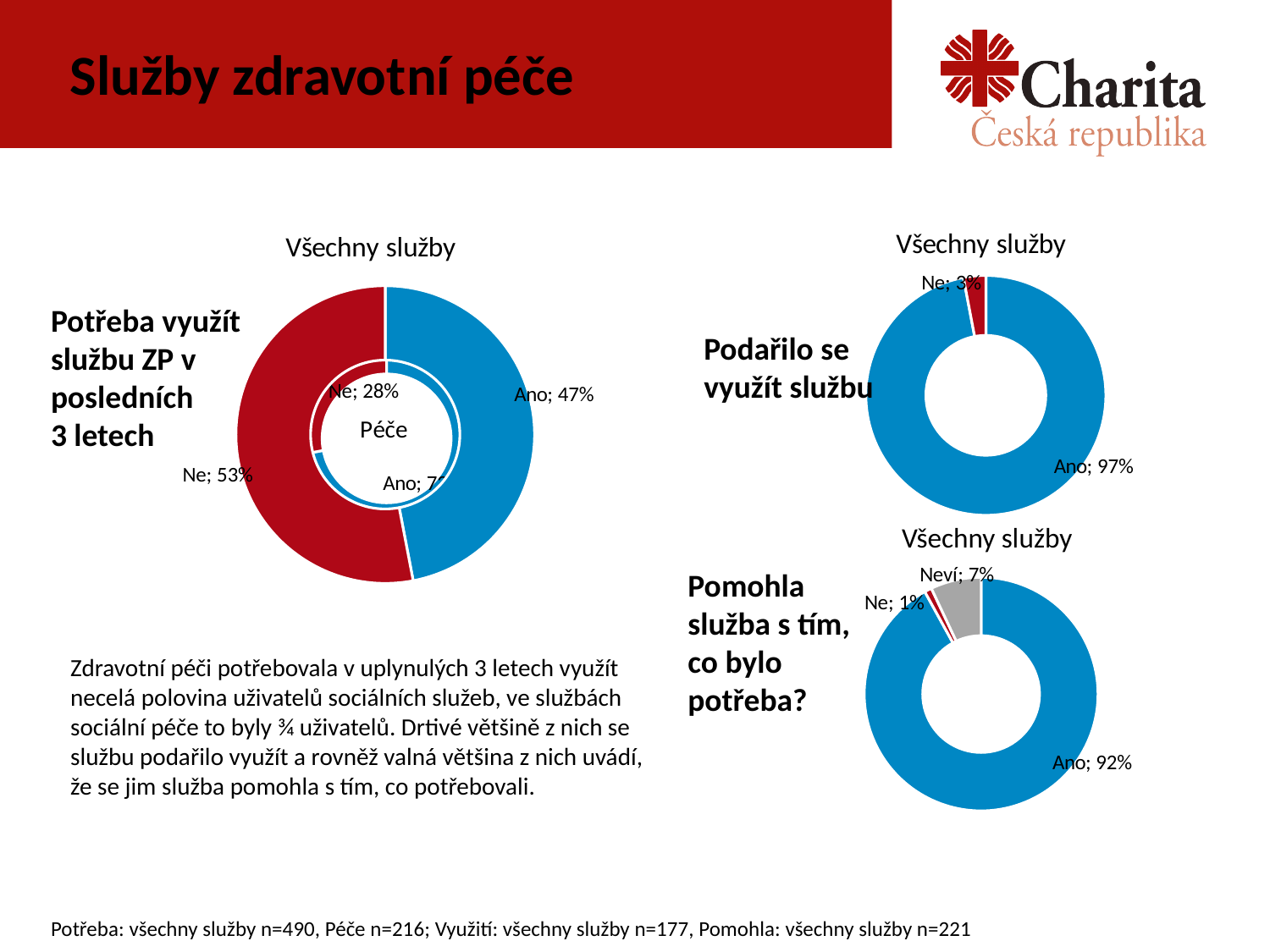
In the chart 'Potřeba využít službu ZP v posledních 3 letech', what is the value for 'Ne' in the outer ring (Všechny služby)? 53% In the chart 'Potřeba využít službu ZP v posledních 3 letech', what is the value for 'Ne' in the inner ring (Péče)? 28% In the chart 'Potřeba využít službu ZP v posledních 3 letech', what is the difference between 'Ne' and 'Ano' in the outer ring? 6% In the chart 'Potřeba využít službu ZP v posledních 3 letech', what is the value for 'Ano' in the outer ring (Všechny služby)? 47% In the chart 'Podařilo se využít službu', what is the value for 'Ne'? 3% In the chart 'Pomohla služba s tím, co bylo potřeba?', what is the value for 'Neví'? 7% What type of chart is used for 'Podařilo se využít službu'? Doughnut chart In the chart 'Potřeba využít službu ZP v posledních 3 letech', which outer-ring category is larger, 'Ano' or 'Ne'? Ne How many categories are shown in the chart 'Pomohla služba s tím, co bylo potřeba?'? 3 In the chart 'Podařilo se využít službu', what is the value for 'Ano'? 97% In the chart 'Pomohla služba s tím, co bylo potřeba?', what is the value for 'Ano'? 92% In the chart 'Pomohla služba s tím, co bylo potřeba?', which category has the lowest value? Ne